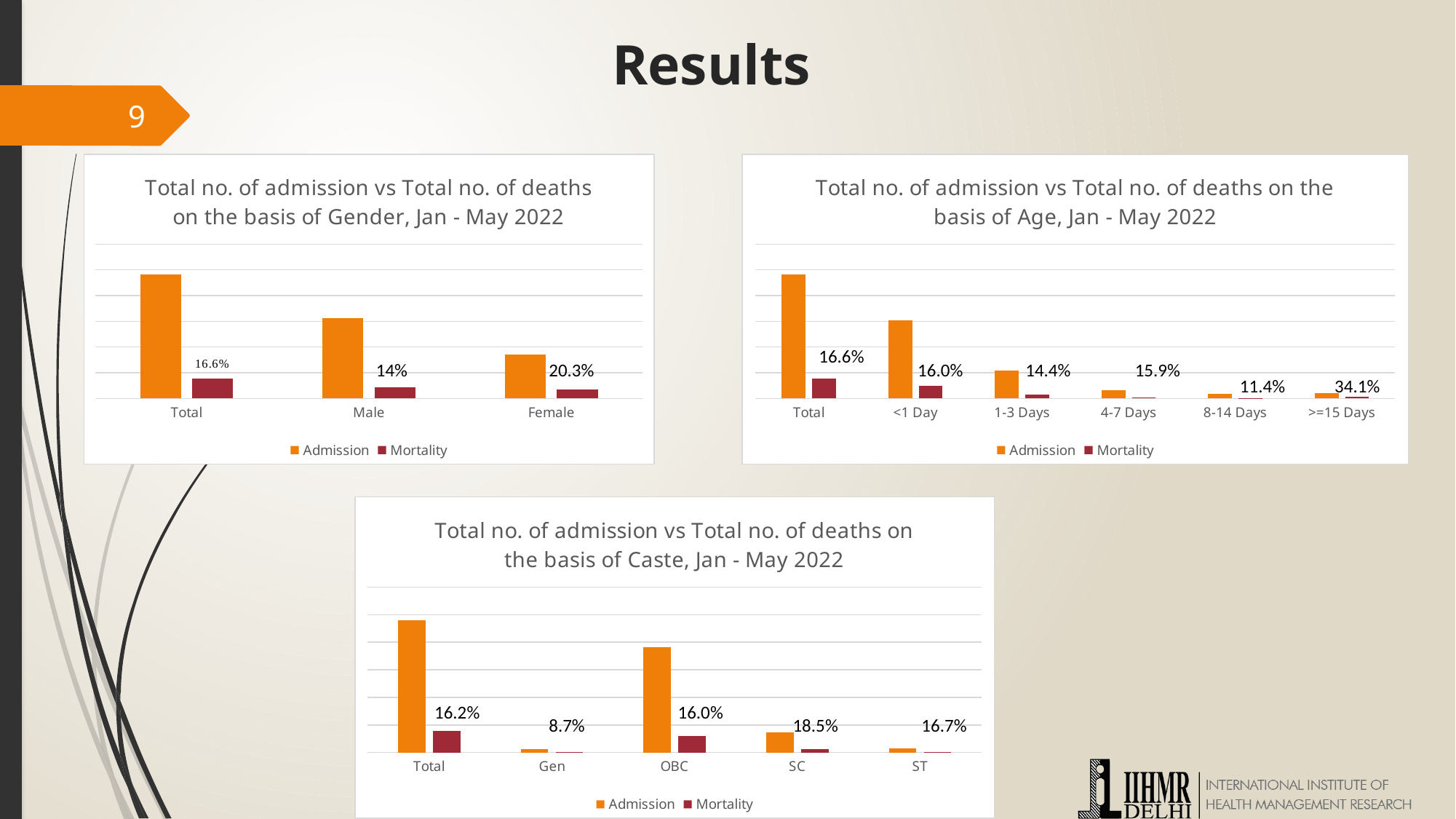
In the chart on the basis of Caste, what is the percentage label shown for SC? 18.5% In the chart on the basis of Age, what is the percentage label shown for >=15 Days? 34.1% In the chart on the basis of Age, what is the difference between the percentage labels for >=15 Days and 8-14 Days? 22.7% What type of chart is the chart on the basis of Gender? Bar chart In the chart on the basis of Gender, which has the taller Admission bar, Male or Female? Male How many series does the legend list in the chart on the basis of Caste? 2 In the chart on the basis of Gender, what is the percentage label shown for Male? 14% In the chart on the basis of Caste, which category has the lowest percentage label? Gen In the chart on the basis of Age, which category has the lowest percentage label? 8-14 Days In the chart on the basis of Gender, what is the percentage label shown for Female? 20.3% In the chart on the basis of Gender, which category has the highest percentage label? Female How many age categories are shown on the x axis of the chart on the basis of Age? 6